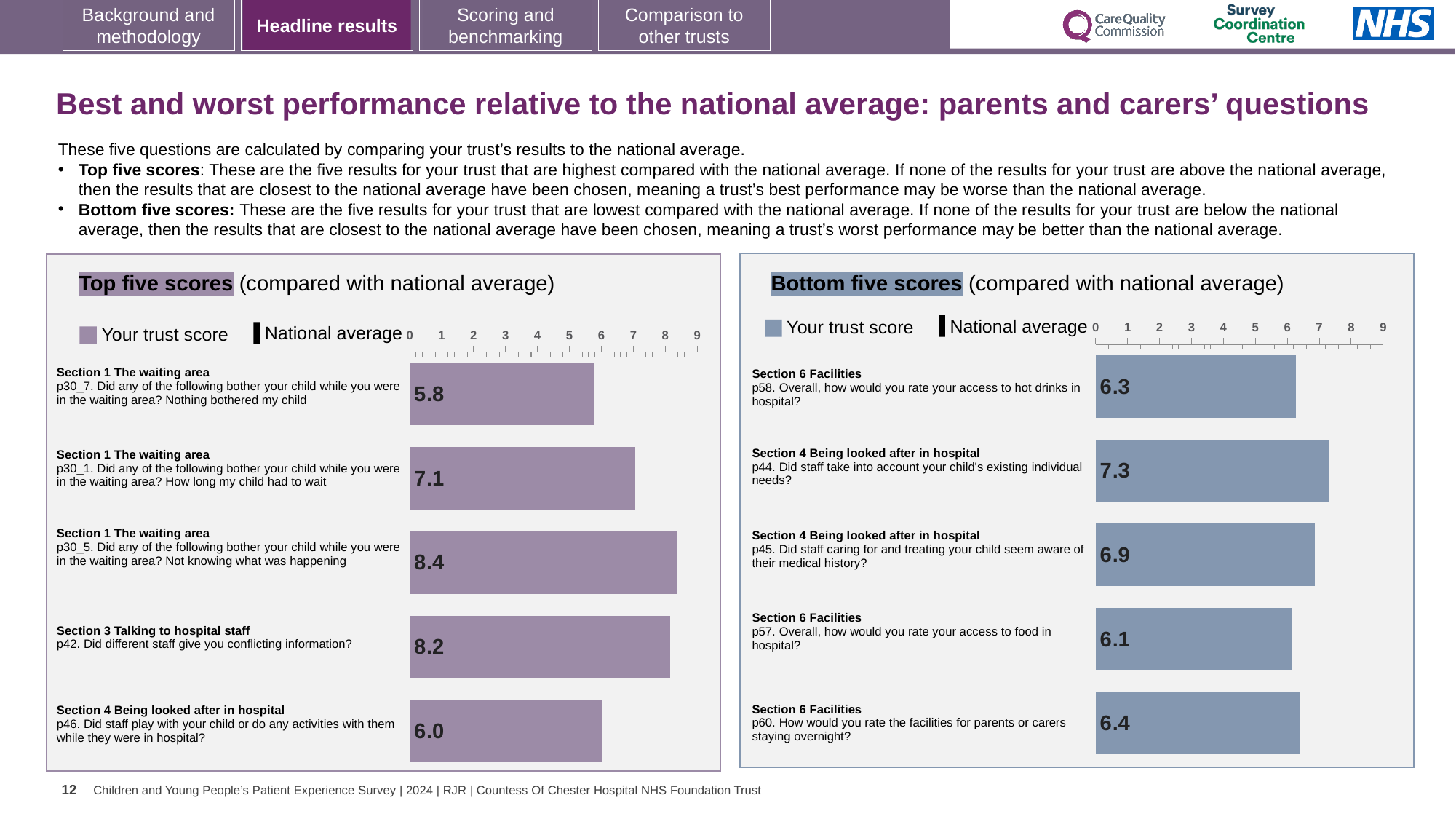
In the Bottom five scores chart, which has the larger trust score: p44 or p45? p44 In the Bottom five scores chart, which question has the lowest trust score? p57. Overall, how would you rate your access to food in hospital? In the Top five scores chart, what is the difference between the trust scores for p30_5 and p30_7? 2.6 In the Bottom five scores chart, what is the trust score for p58 (access to hot drinks in hospital)? 6.3 In the Bottom five scores chart, what is the trust score for p60 (facilities for parents or carers staying overnight)? 6.4 In the Top five scores chart, is the trust score for p46 greater or less than 7? less How many entries does the legend of the Top five scores chart list? 2 In the Top five scores chart, what is the trust score for p30_7 (Nothing bothered my child)? 5.8 What type of chart is the Top five scores chart? Bar chart In the Top five scores chart, which question has the highest trust score? p30_5. Not knowing what was happening In the Top five scores chart, what is the trust score for p42 (Did different staff give you conflicting information?)? 8.2 How many bars are shown in the Bottom five scores chart? 5